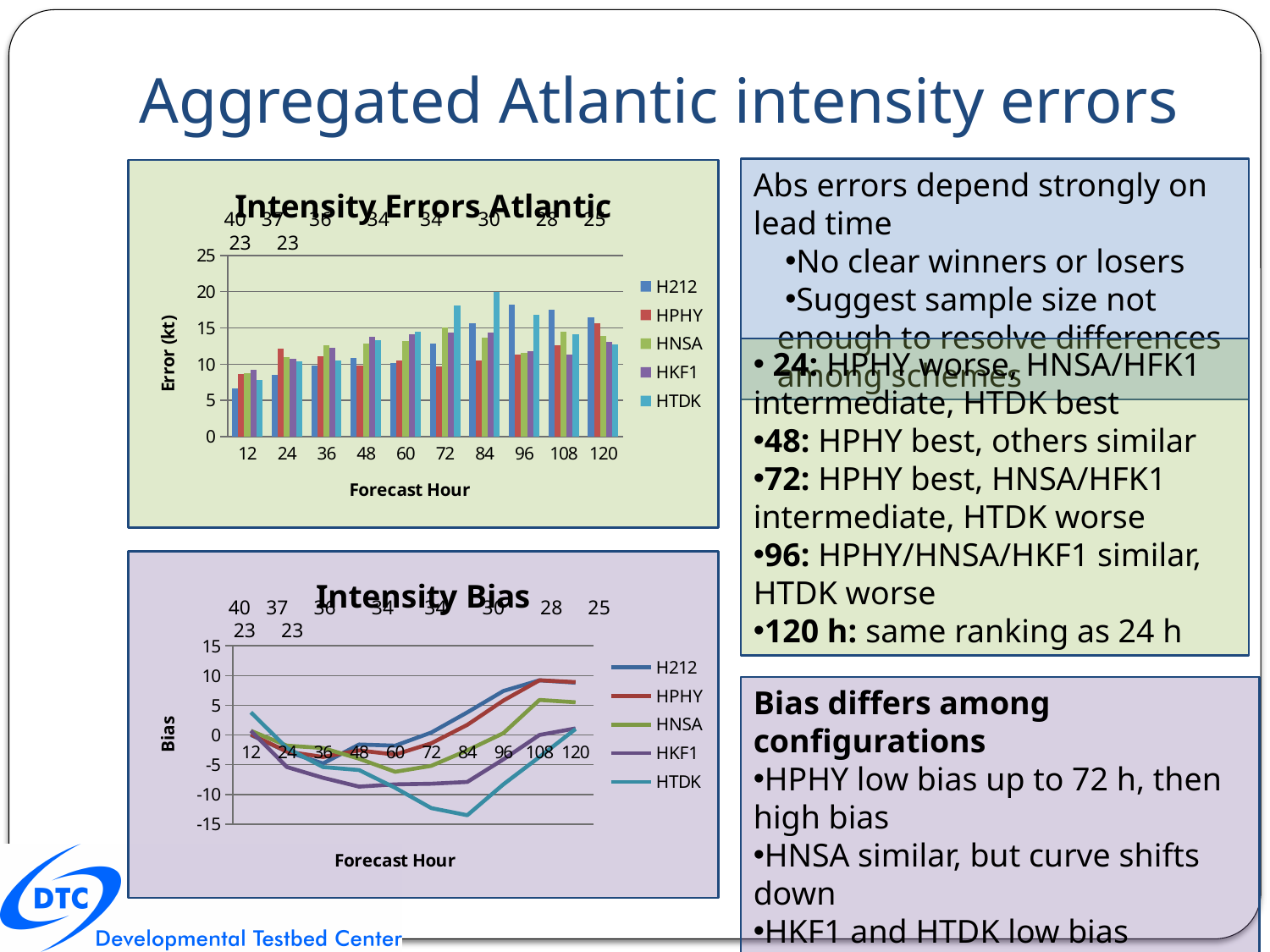
In the Intensity Errors Atlantic chart, which series has the lowest error at forecast hour 12? H212 How many series does the legend of the Intensity Errors Atlantic chart list? 5 How many forecast hour categories are shown on the x axis of the Intensity Bias chart? 10 In the Intensity Errors Atlantic chart, is the value for HTDK at forecast hour 72 greater or less than 15? greater In the Intensity Bias chart, which series has the lowest bias at forecast hour 84? HTDK In the Intensity Bias chart, does the HPHY line rise or fall between forecast hours 72 and 108? rise In the Intensity Errors Atlantic chart, which series has the highest error at forecast hour 72? HTDK What is the y-axis label of the Intensity Errors Atlantic chart? Error (kt) In the Intensity Bias chart, is the value for HTDK at forecast hour 84 greater or less than -10? less What kind of chart is the Intensity Bias chart? line chart What kind of chart is the Intensity Errors Atlantic chart? bar chart In the Intensity Errors Atlantic chart, is the value for H212 at forecast hour 12 greater or less than 10? less